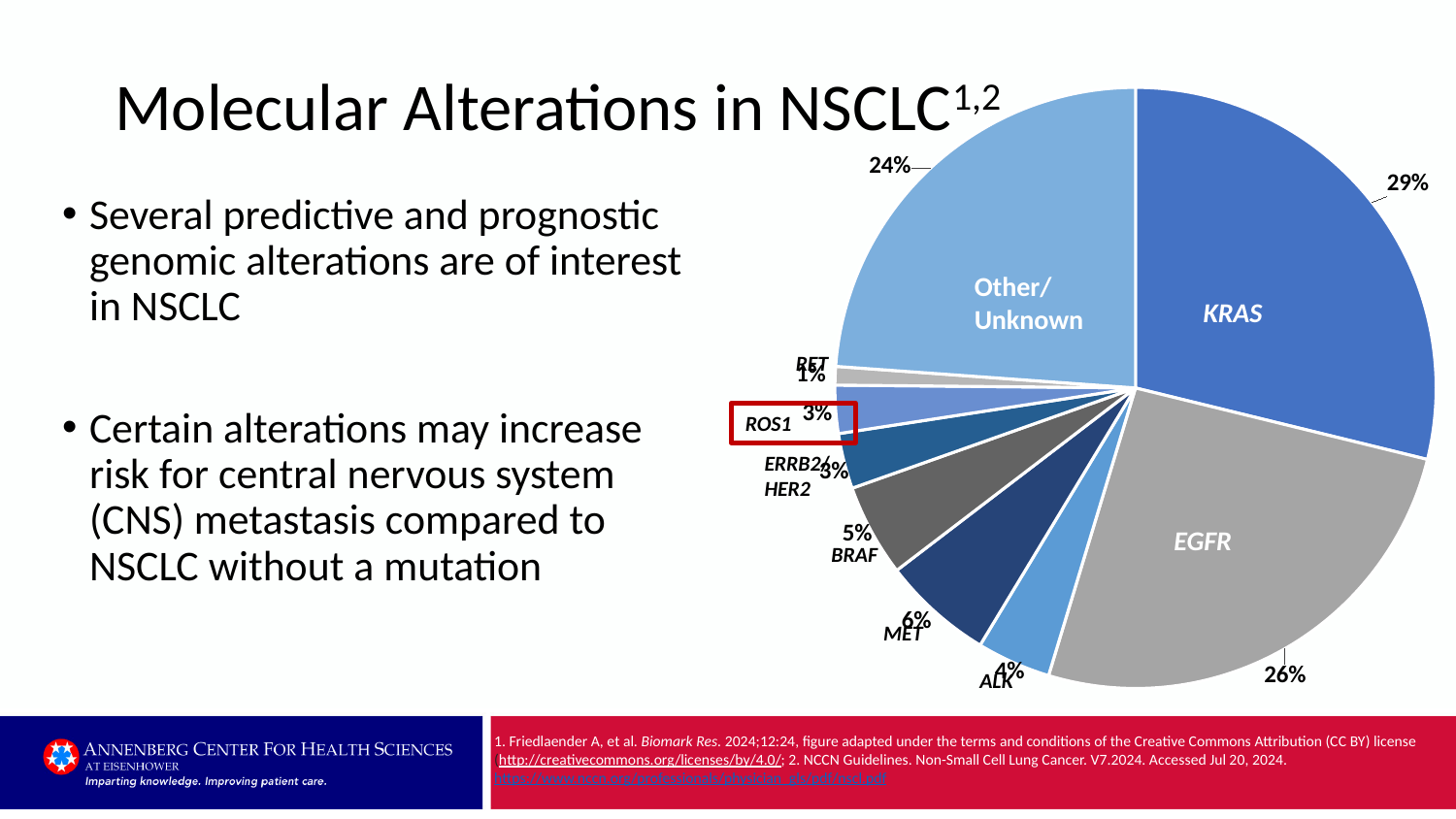
Which slice is larger, MET or ALK? MET What percentage of the pie is labelled BRAF? 5% Which slice is highlighted with a red box on the slide? ROS1 What is the difference in percentage points between the KRAS slice and the EGFR slice? 3% Which molecular alteration has the largest slice of the pie? KRAS Which slice is larger, KRAS or EGFR? KRAS What percentage of the pie is labelled KRAS? 29% What percentage of the pie is labelled EGFR? 26% What percentage of the pie is labelled Other/Unknown? 24% What type of chart is shown on the slide? pie chart What percentage of the pie is labelled MET? 6% What percentage of the pie is labelled ALK? 4%